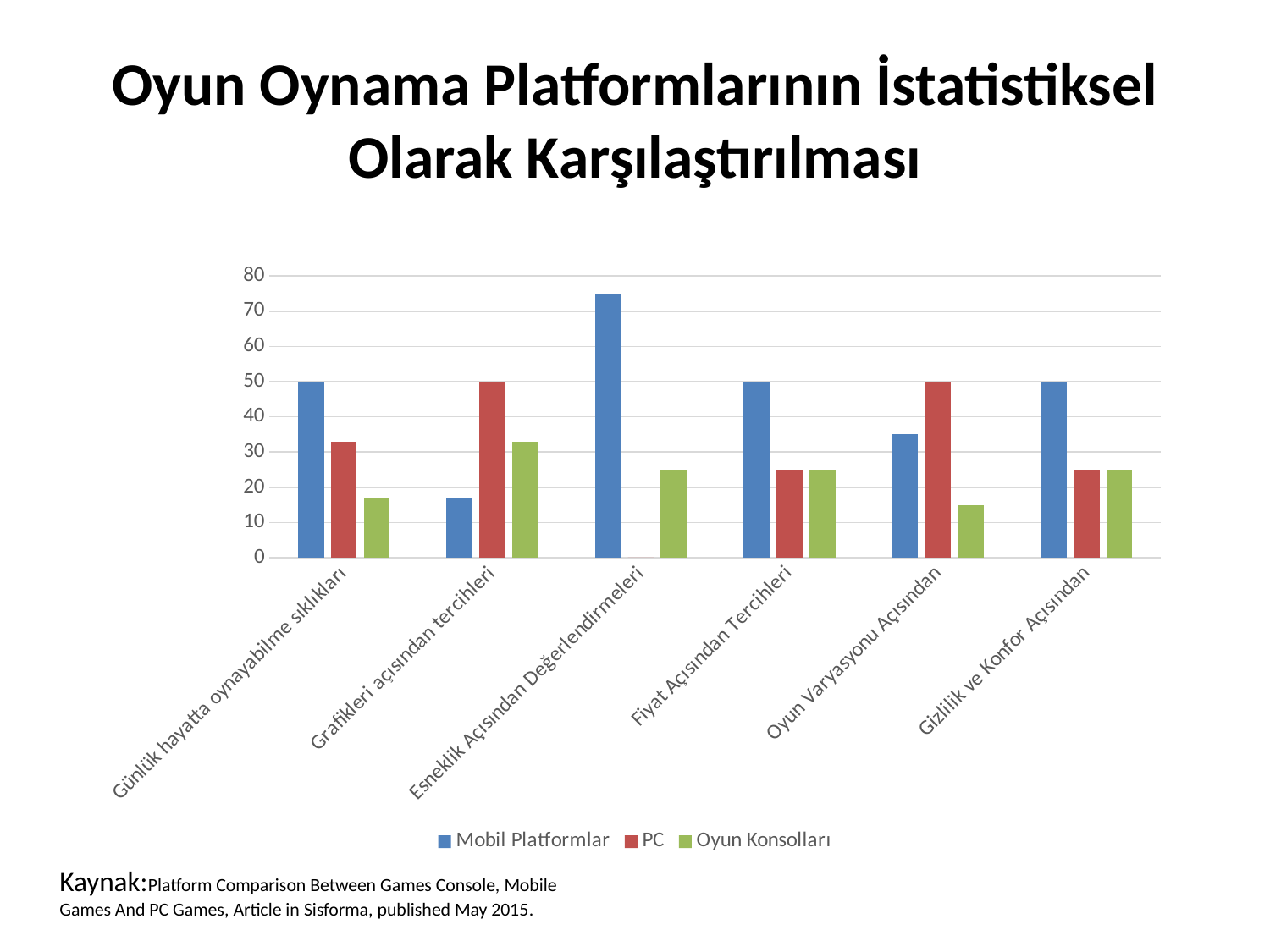
In the category 'Günlük hayatta oynayabilme sıklıkları', which is larger: Mobil Platformlar or PC? Mobil Platformlar What is the value for Mobil Platformlar in the category 'Gizlilik ve Konfor Açısından'? 50 What kind of chart is shown on the slide? bar chart How many categories are shown on the x axis? 6 Is the value for Mobil Platformlar in 'Esneklik Açısından Değerlendirmeleri' greater or less than 70? greater How many series does the legend list? 3 In which category is the Mobil Platformlar bar lowest? Grafikleri açısından tercihleri Which series is shown in green in the legend? Oyun Konsolları What is the value for Mobil Platformlar in the category 'Günlük hayatta oynayabilme sıklıkları'? 50 What is the value for PC in the category 'Grafikleri açısından tercihleri'? 50 In which category is the Mobil Platformlar bar highest? Esneklik Açısından Değerlendirmeleri Is the value for Oyun Konsolları in 'Oyun Varyasyonu Açısından' greater or less than 20? less